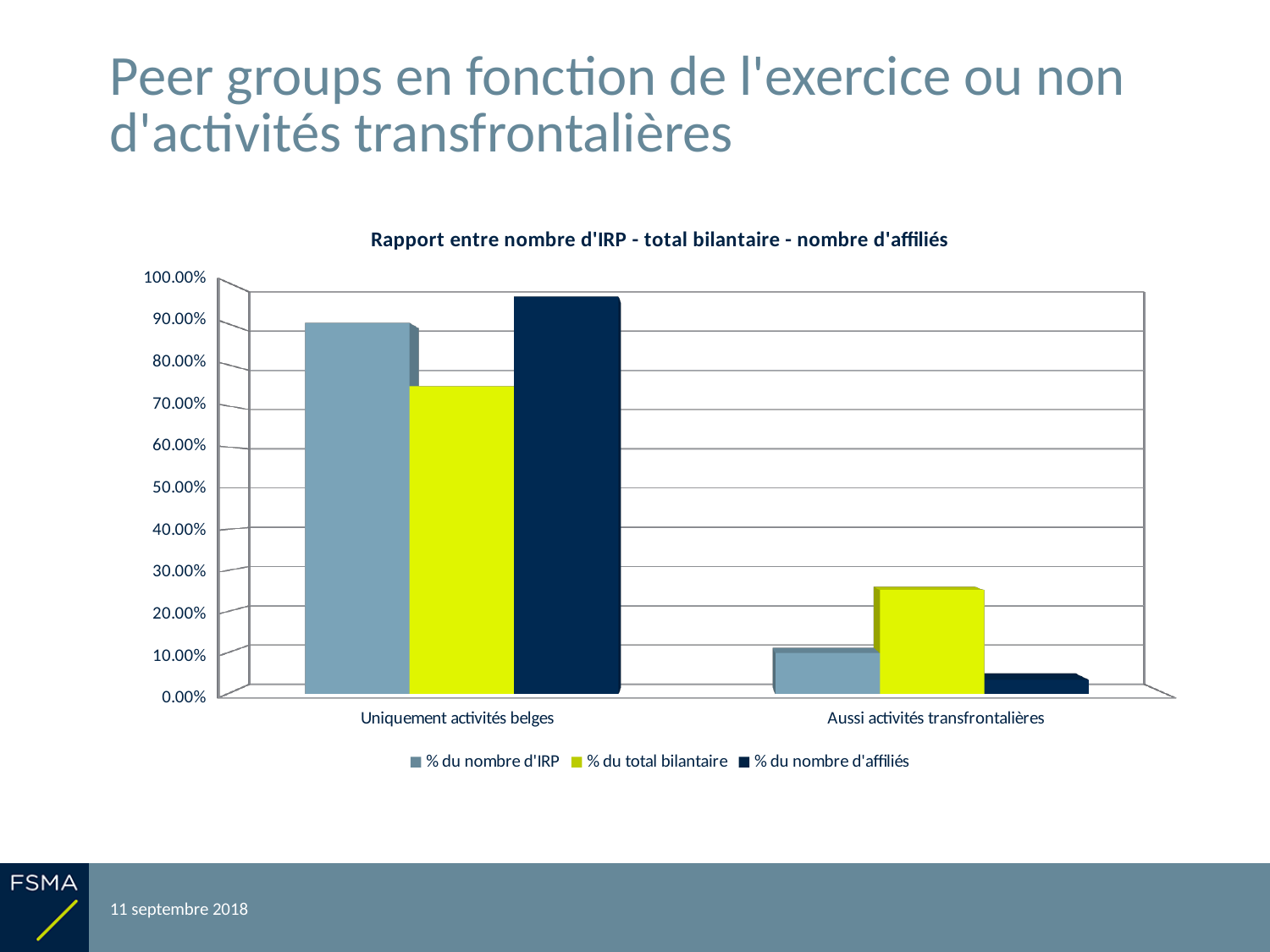
How many series does the legend list? 3 Which series is shown in yellow-green in the legend? % du total bilantaire Is the value of '% du nombre d'affiliés' for 'Aussi activités transfrontalières' greater or less than 10.00%? less Which series has the lowest value for 'Aussi activités transfrontalières'? % du nombre d'affiliés Which series has the highest value for 'Uniquement activités belges'? % du nombre d'affiliés What kind of chart is shown on the slide? bar chart Which series has the highest value for 'Aussi activités transfrontalières'? % du total bilantaire For 'Uniquement activités belges', which is larger: '% du nombre d'IRP' or '% du total bilantaire'? % du nombre d'IRP Is the value of '% du nombre d'IRP' for 'Uniquement activités belges' greater or less than 80.00%? greater Is the value of '% du total bilantaire' for 'Aussi activités transfrontalières' greater or less than 20.00%? greater How many categories are shown on the x axis? 2 What is the title of the chart? Rapport entre nombre d'IRP - total bilantaire - nombre d'affiliés